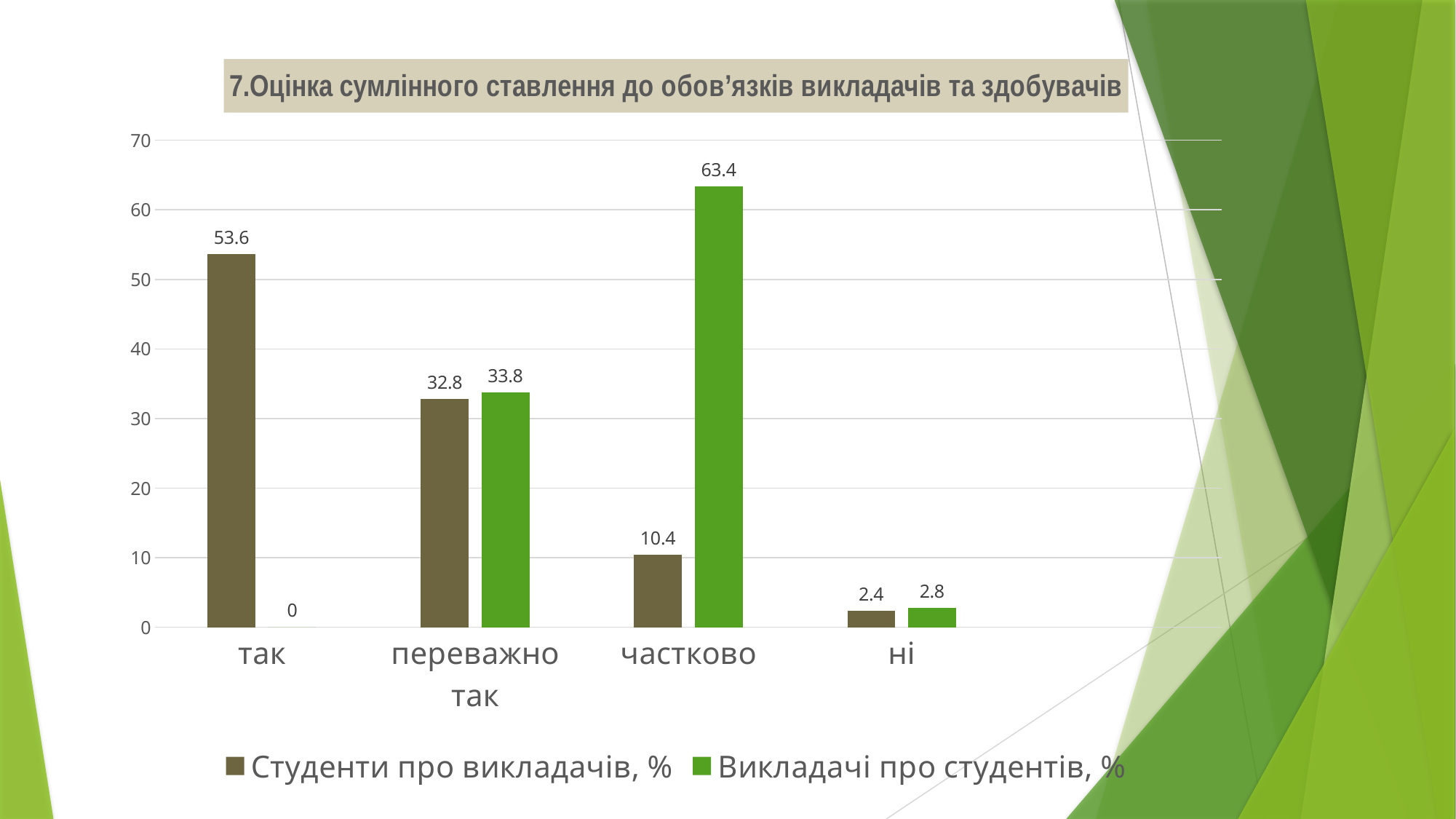
What is the title of the chart? 7.Оцінка сумлінного ставлення до обов’язків викладачів та здобувачів How many series does the legend list? 2 What kind of chart is shown on the slide? bar chart Which category has the lowest value in the series "Викладачі про студентів, %"? так Which category has the highest value in the series "Студенти про викладачів, %"? так What is the value for "ні" in the series "Студенти про викладачів, %"? 2.4 What is the value for "так" in the series "Студенти про викладачів, %"? 53.6 What is the value for "так" in the series "Викладачі про студентів, %"? 0 For "переважно так", which series has the larger value? Викладачі про студентів, % What is the value for "частково" in the series "Викладачі про студентів, %"? 63.4 How many categories are shown on the x axis? 4 What is the difference between the two series' values for "частково"? 53